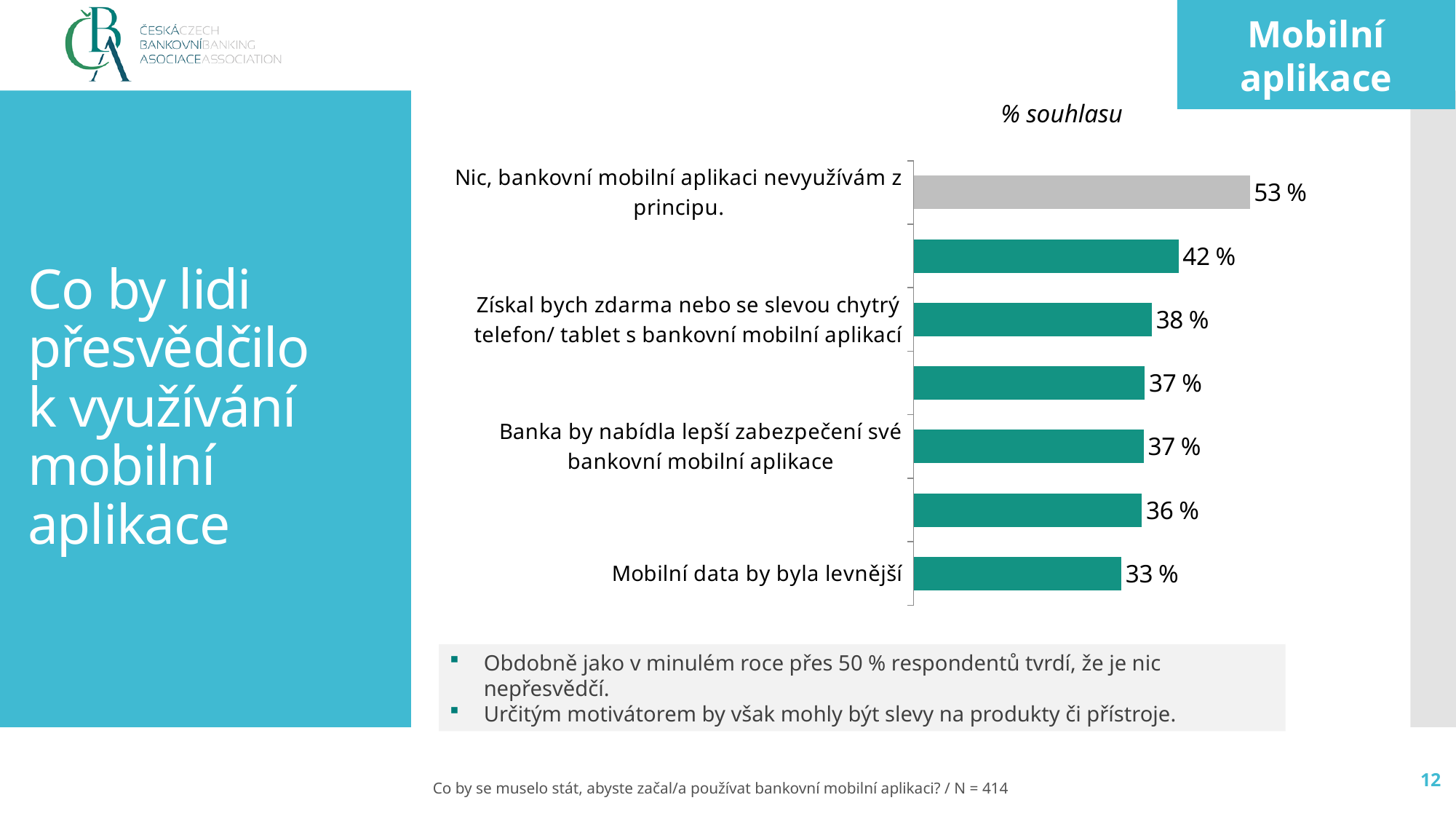
What is the value for "Nic, bankovní mobilní aplikaci nevyužívám z principu."? 53 % What colour is the bar for "Nic, bankovní mobilní aplikaci nevyužívám z principu."? Grey Which is larger: the value for "Získal bych zdarma nebo se slevou chytrý telefon/ tablet s bankovní mobilní aplikací" or the value for "Mobilní data by byla levnější"? Získal bych zdarma nebo se slevou chytrý telefon/ tablet s bankovní mobilní aplikací What is the title shown above the chart? % souhlasu What is the value for "Banka by nabídla lepší zabezpečení své bankovní mobilní aplikace"? 37 % What kind of chart is shown on the slide? Bar chart What is the value for "Mobilní data by byla levnější"? 33 % What is the difference between the value for "Nic, bankovní mobilní aplikaci nevyužívám z principu." and the value for "Mobilní data by byla levnější"? 20 % What is the value for "Získal bych zdarma nebo se slevou chytrý telefon/ tablet s bankovní mobilní aplikací"? 38 % How many bars are plotted in the chart? 7 Which category has the lowest value? Mobilní data by byla levnější Which category has the highest value? Nic, bankovní mobilní aplikaci nevyužívám z principu.